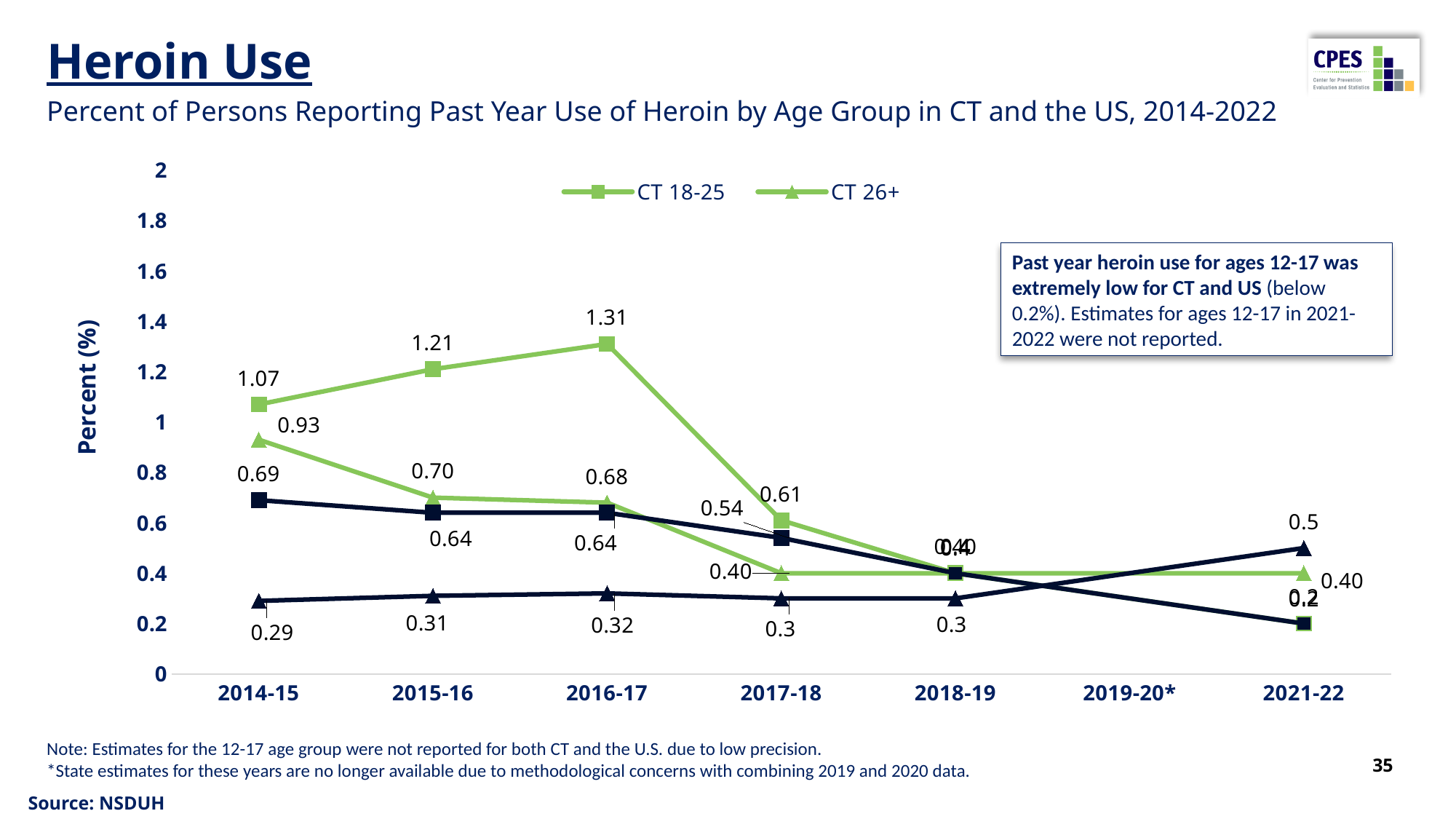
How many year categories are shown on the x axis? 7 In which year does the CT 26+ series reach its highest value? 2014-15 Which is larger in 2017-18, CT 18-25 or CT 26+? CT 18-25 What kind of chart is shown on the slide? line chart Does the CT 26+ series rise or fall from 2014-15 to 2017-18? fall What is the difference between CT 18-25 and CT 26+ in 2015-16? 0.51 What is the value for CT 18-25 in 2016-17? 1.31 What is the value for CT 26+ in 2014-15? 0.93 In which year does the CT 18-25 series reach its highest value? 2016-17 Is the value for CT 18-25 in 2016-17 greater or less than 1.2? greater How many series does the legend list? 2 What is the value for CT 26+ in 2021-22? 0.40